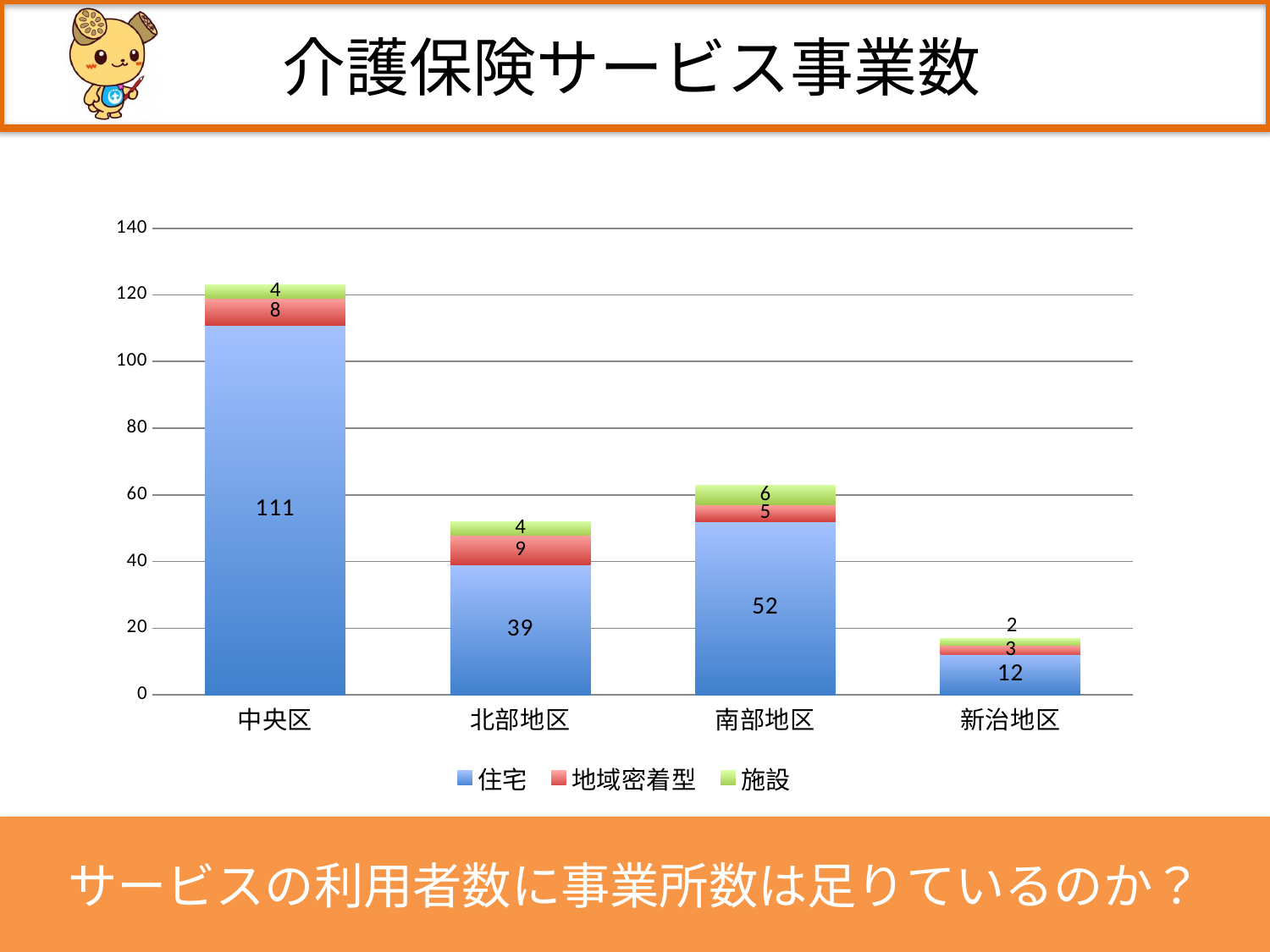
How many categories are shown on the x axis? 4 How many series does the legend list? 3 What is the value of 地域密着型 for 北部地区? 9 Which category has the highest 住宅 value? 中央区 What is the value of 住宅 for 中央区? 111 Which category has the lowest 施設 value? 新治地区 What is the total of the stacked bar for 北部地区? 52 What is the value of 施設 for 南部地区? 6 Which is larger, the 地域密着型 value for 北部地区 or for 南部地区? 北部地区 What is the difference between the 住宅 values for 中央区 and 南部地区? 59 What kind of chart is shown on the slide? stacked bar chart What is the value of 住宅 for 新治地区? 12